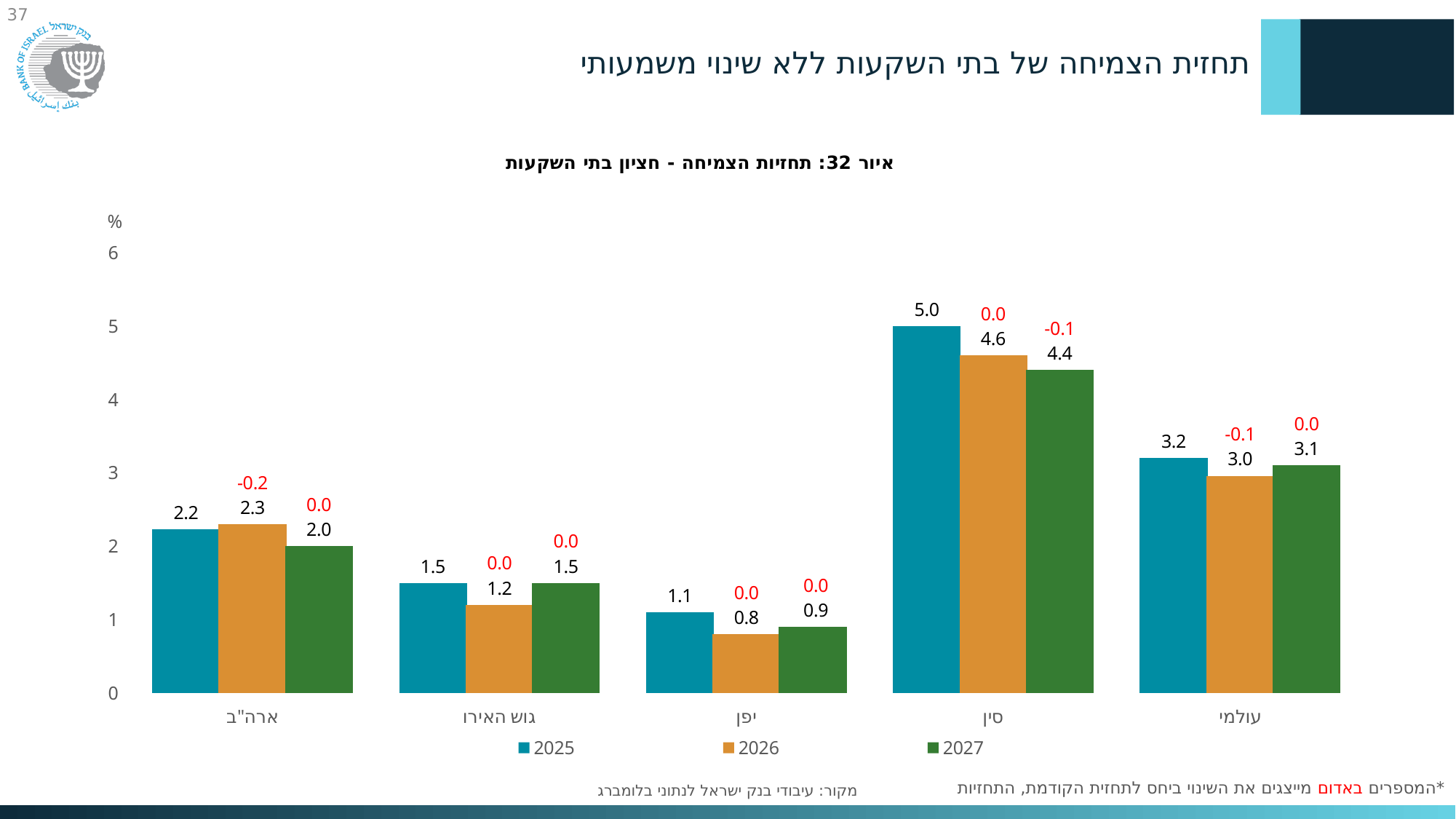
Which is larger: the 2026 value for גוש האירו or the 2026 value for ארה"ב? ארה"ב What is the red number shown above the 2026 bar for ארה"ב? -0.2 What is the 2027 value for ארה"ב? 2.0 How many categories are shown on the x axis? 5 What kind of chart is shown? bar chart Which category has the highest 2025 value? סין Which category has the lowest 2027 value? יפן What is the 2026 value for עולמי? 3.0 What is the difference between the 2025 and 2027 values for סין? 0.6 What is the 2026 value for יפן? 0.8 How many series does the legend list? 3 What is the 2025 value for סין? 5.0